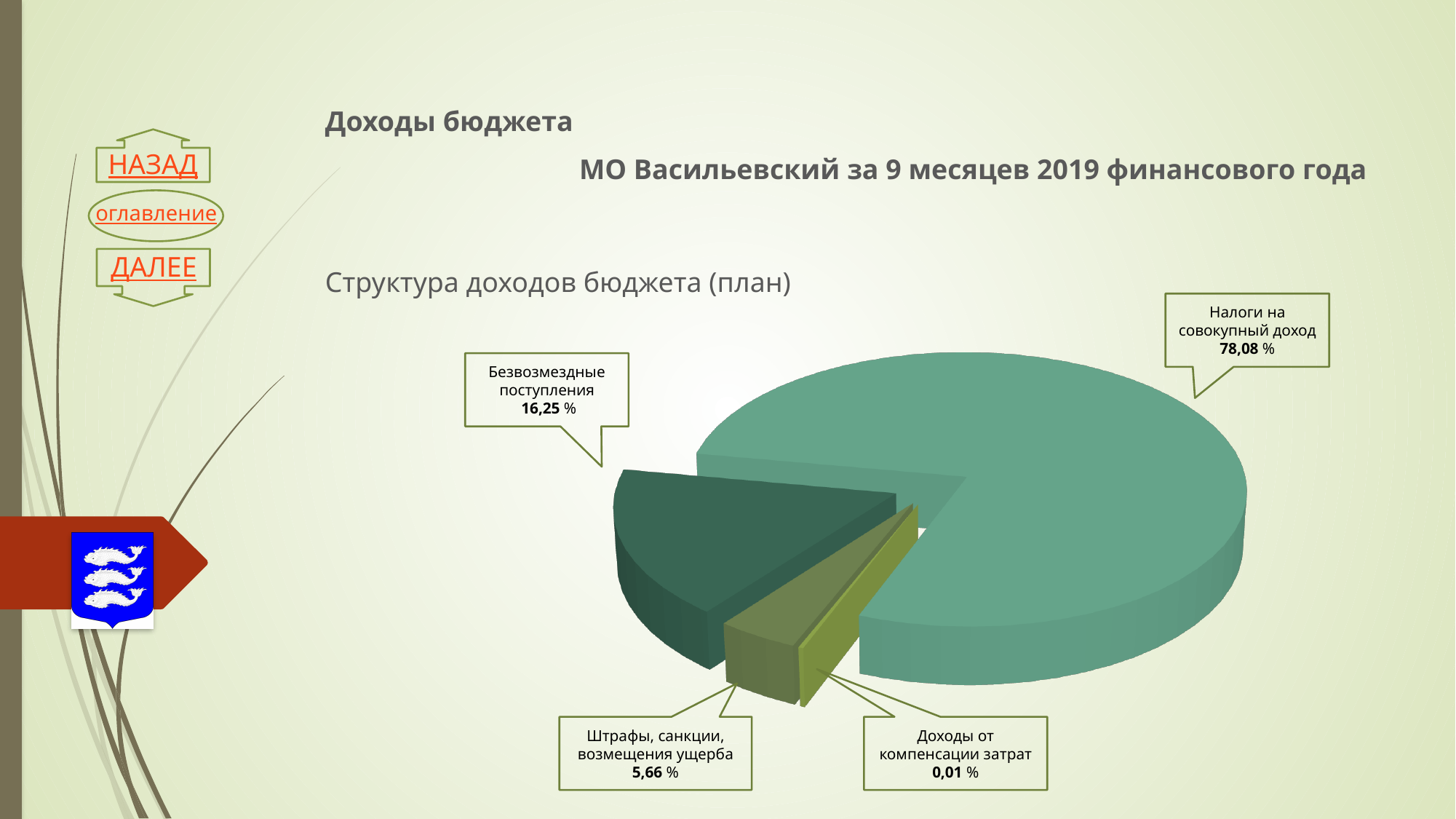
What is the difference in percentage points between "Штрафы, санкции, возмещения ущерба" and "Доходы от компенсации затрат"? 5,65 Which is larger: the share for "Безвозмездные поступления" or for "Штрафы, санкции, возмещения ущерба"? Безвозмездные поступления What is the title of the chart? Структура доходов бюджета (план) What share of the pie does "Безвозмездные поступления" represent? 16,25 % Which category has the smallest share of the pie? Доходы от компенсации затрат What is the difference in percentage points between "Налоги на совокупный доход" and "Безвозмездные поступления"? 61,83 How many slices does the pie chart have? 4 Which category has the largest share of the pie? Налоги на совокупный доход What share of the pie does "Штрафы, санкции, возмещения ущерба" represent? 5,66 % What share of the pie does "Доходы от компенсации затрат" represent? 0,01 % What kind of chart is shown on the slide? Pie chart What share of the pie does "Налоги на совокупный доход" represent? 78,08 %